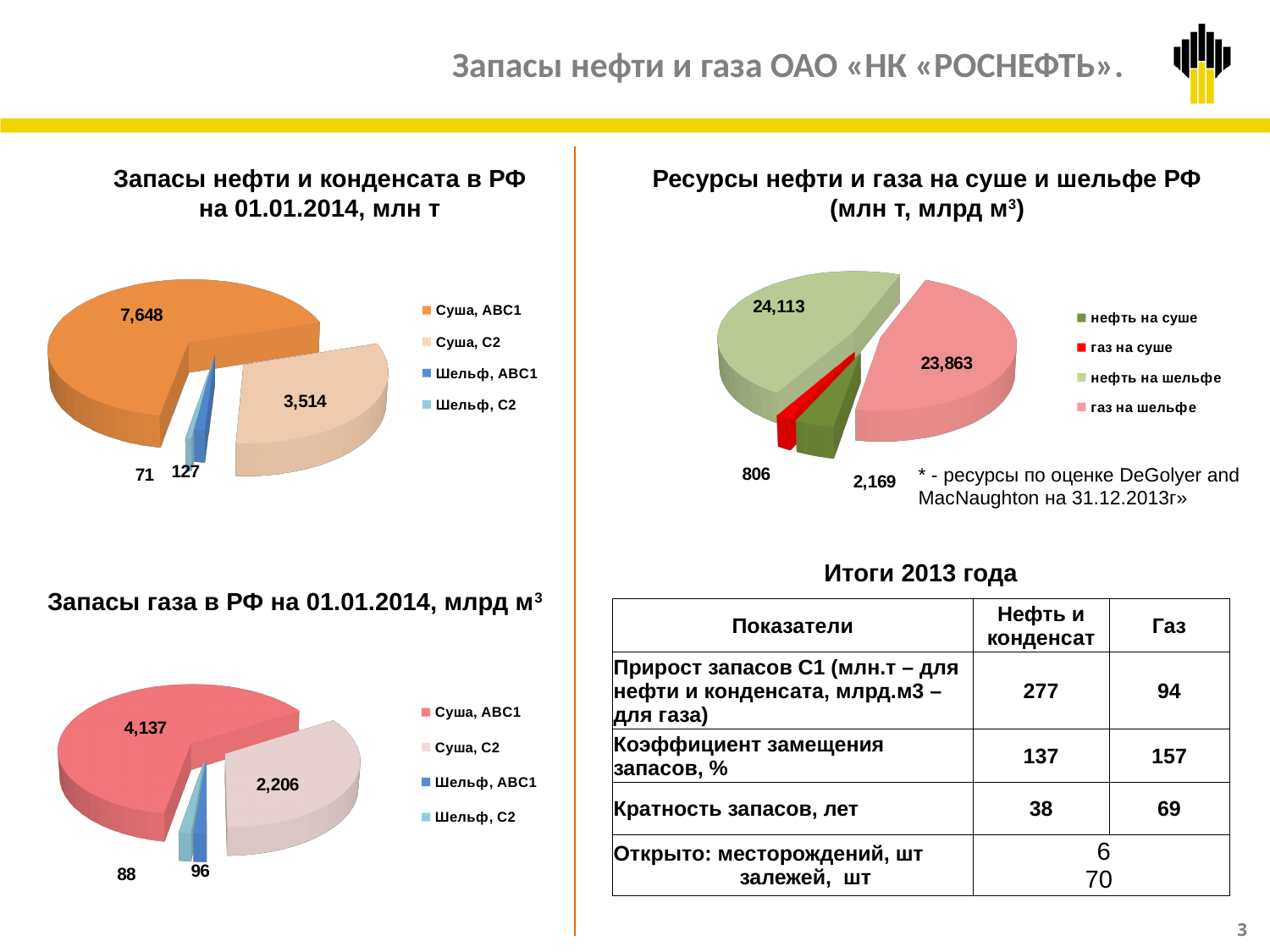
In the chart 'Ресурсы нефти и газа на суше и шельфе РФ', what is the value for газ на суше? 806 In the chart 'Запасы нефти и конденсата в РФ на 01.01.2014, млн т', what is the difference between Суша, ABC1 and Суша, C2? 4,134 In the chart 'Ресурсы нефти и газа на суше и шельфе РФ', what is the value for нефть на шельфе? 24,113 What kind of chart is 'Ресурсы нефти и газа на суше и шельфе РФ'? Pie chart In the chart 'Запасы нефти и конденсата в РФ на 01.01.2014, млн т', what is the value for Шельф, ABC1? 127 In the chart 'Запасы нефти и конденсата в РФ на 01.01.2014, млн т', what is the value for Суша, ABC1? 7,648 In the chart 'Запасы газа в РФ на 01.01.2014, млрд м3', how many categories does the legend list? 4 In the chart 'Ресурсы нефти и газа на суше и шельфе РФ', which category has the largest value? нефть на шельфе In the chart 'Запасы газа в РФ на 01.01.2014, млрд м3', which is larger: Шельф, ABC1 or Шельф, C2? Шельф, ABC1 In the chart 'Запасы газа в РФ на 01.01.2014, млрд м3', what is the value for Суша, C2? 2,206 In the chart 'Запасы нефти и конденсата в РФ на 01.01.2014, млн т', which category has the smallest slice? Шельф, C2 In the chart 'Ресурсы нефти и газа на суше и шельфе РФ', what colour is the slice for газ на суше? Red